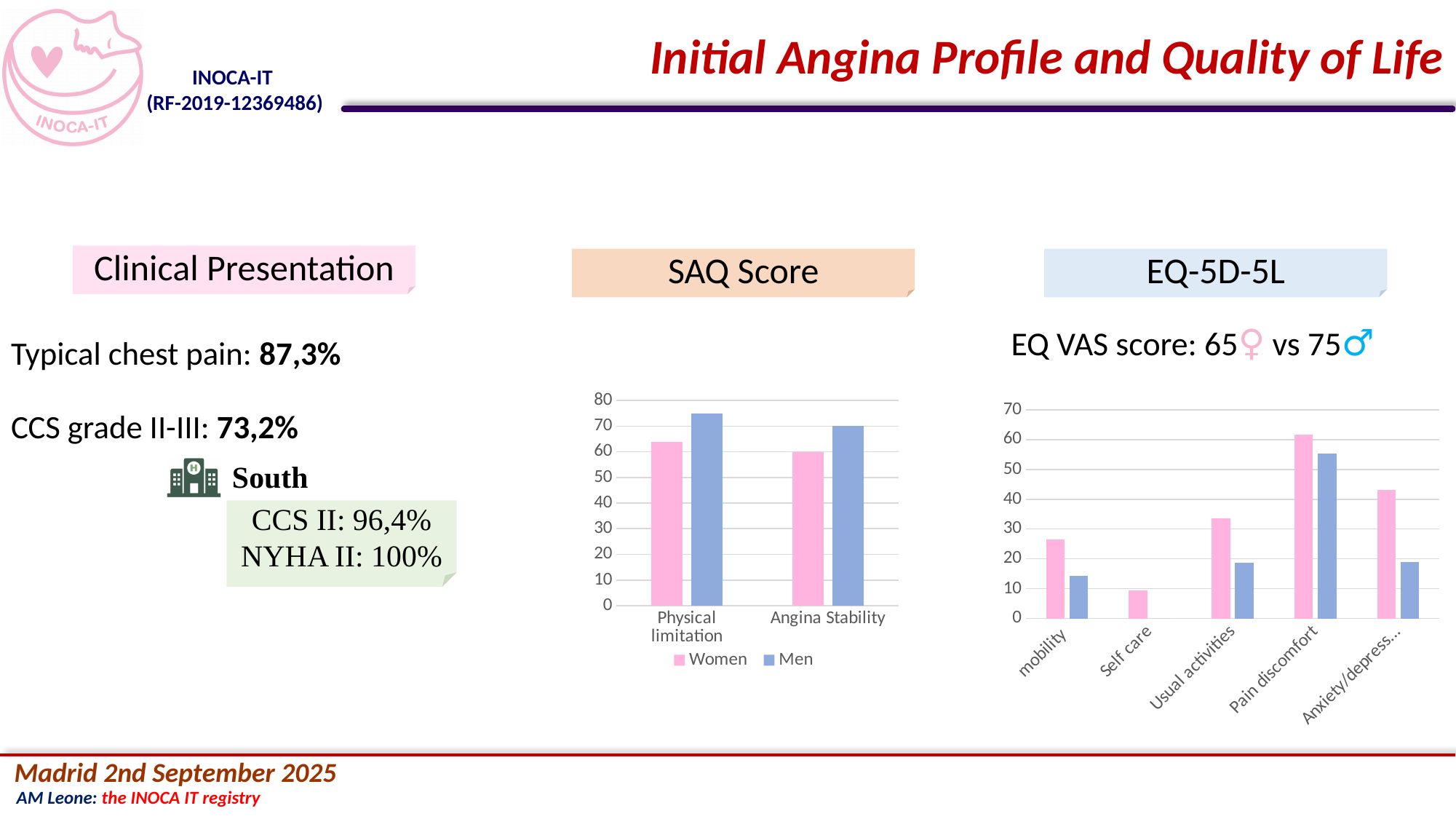
On the SAQ Score chart, what is the value for Women for Angina Stability? 60 On the EQ-5D-5L chart, which category has the lowest pink bar? Self care How many series does the legend of the SAQ Score chart list? 2 What kind of chart is the SAQ Score chart? bar chart How many categories are shown on the x axis of the EQ-5D-5L chart? 5 On the EQ-5D-5L chart, which category has the highest pink bar? Pain discomfort On the SAQ Score chart, which is larger for Physical limitation, Women or Men? Men How many categories are shown on the x axis of the SAQ Score chart? 2 On the SAQ Score chart, is the value for Men for Physical limitation greater or less than 70? greater On the SAQ Score chart, what is the value for Men for Angina Stability? 70 On the EQ-5D-5L chart, is the blue bar for mobility greater or less than 20? less What are the two legend entries on the SAQ Score chart? Women and Men